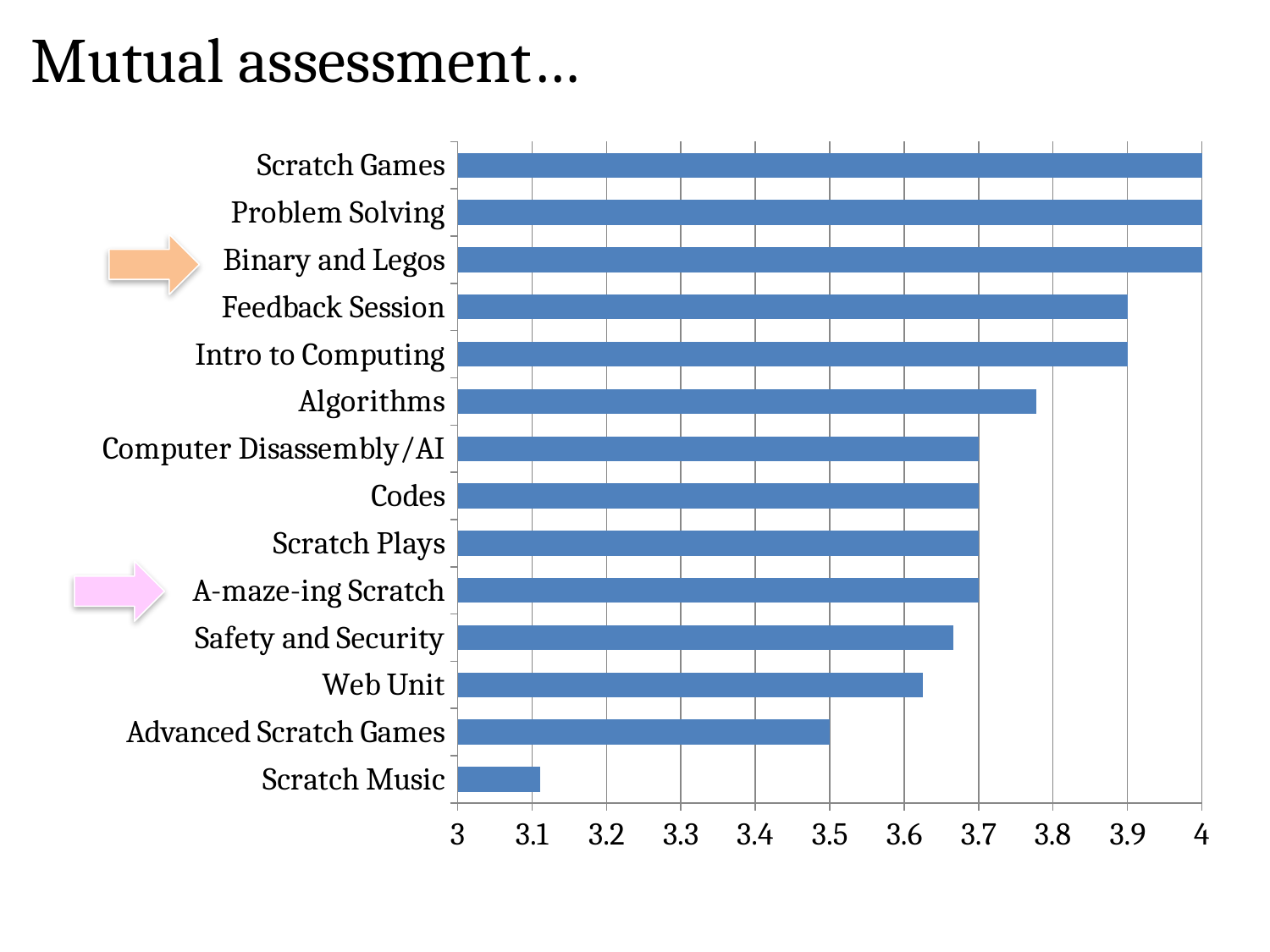
Is the value for Scratch Music greater or less than 3.2? less Is the value for Algorithms greater or less than 3.7? greater What is the value for Scratch Games? 4 Which category has the lowest value in the chart? Scratch Music What is the value for Advanced Scratch Games? 3.5 What is the value for Feedback Session? 3.9 What is the value for Codes? 3.7 What is the title of the slide containing the chart? Mutual assessment… How many categories are plotted in the chart? 14 What kind of chart is shown on the slide? bar chart What is the difference between the values for Feedback Session and Advanced Scratch Games? 0.4 Which has a larger value, Web Unit or Advanced Scratch Games? Web Unit